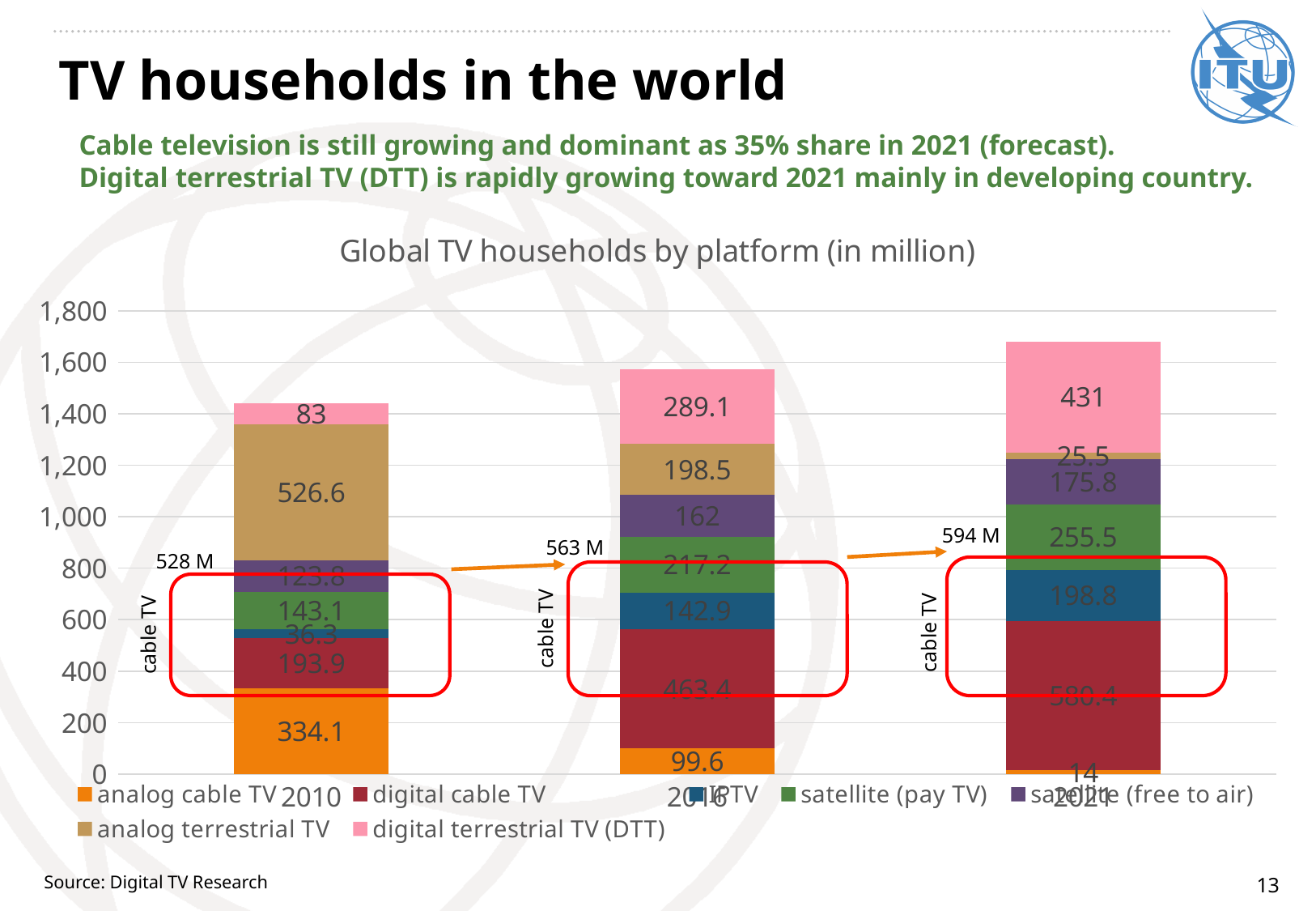
What is the difference between the digital terrestrial TV (DTT) values for 2016 and 2010? 206.1 What kind of chart is shown on the slide? stacked bar chart Does the digital terrestrial TV (DTT) value rise or fall from 2010 to 2021? rise Which year has the tallest stacked bar overall? 2021 What is the value for analog terrestrial TV in 2010? 526.6 How many years are shown on the x axis? 3 How many series does the legend list? 7 In 2021, which is larger: satellite (pay TV) or satellite (free to air)? satellite (pay TV) What is the total of the 2010 stacked bar? 1440.8 What is the value for digital terrestrial TV (DTT) in 2021? 431 What is the value for analog cable TV in 2010? 334.1 What is the value for IPTV in 2016? 142.9